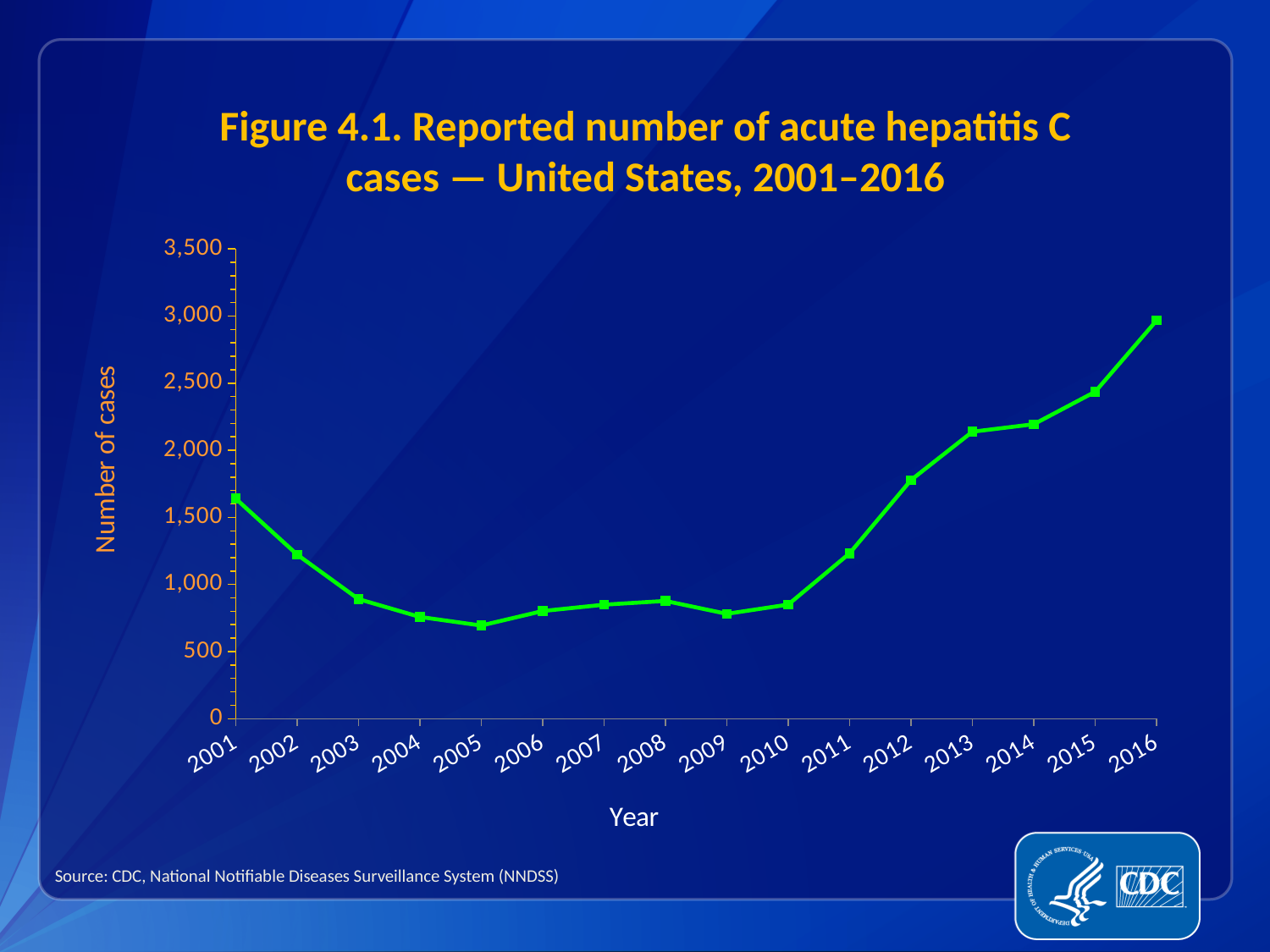
Is the value for 2013 greater or less than 2,000? greater Do the reported cases rise or fall from 2010 to 2016? Rise Which year has the highest reported number of acute hepatitis C cases? 2016 How many years (data points) are plotted on the chart? 16 Which year has more reported cases, 2001 or 2002? 2001 Is the value for 2016 greater or less than 2,500? greater What is the label of the vertical axis? Number of cases Which year has the lowest reported number of acute hepatitis C cases? 2005 Is the value for 2001 greater or less than 1,500? greater What kind of chart is shown on the slide? Line chart Which year has more reported cases, 2011 or 2012? 2012